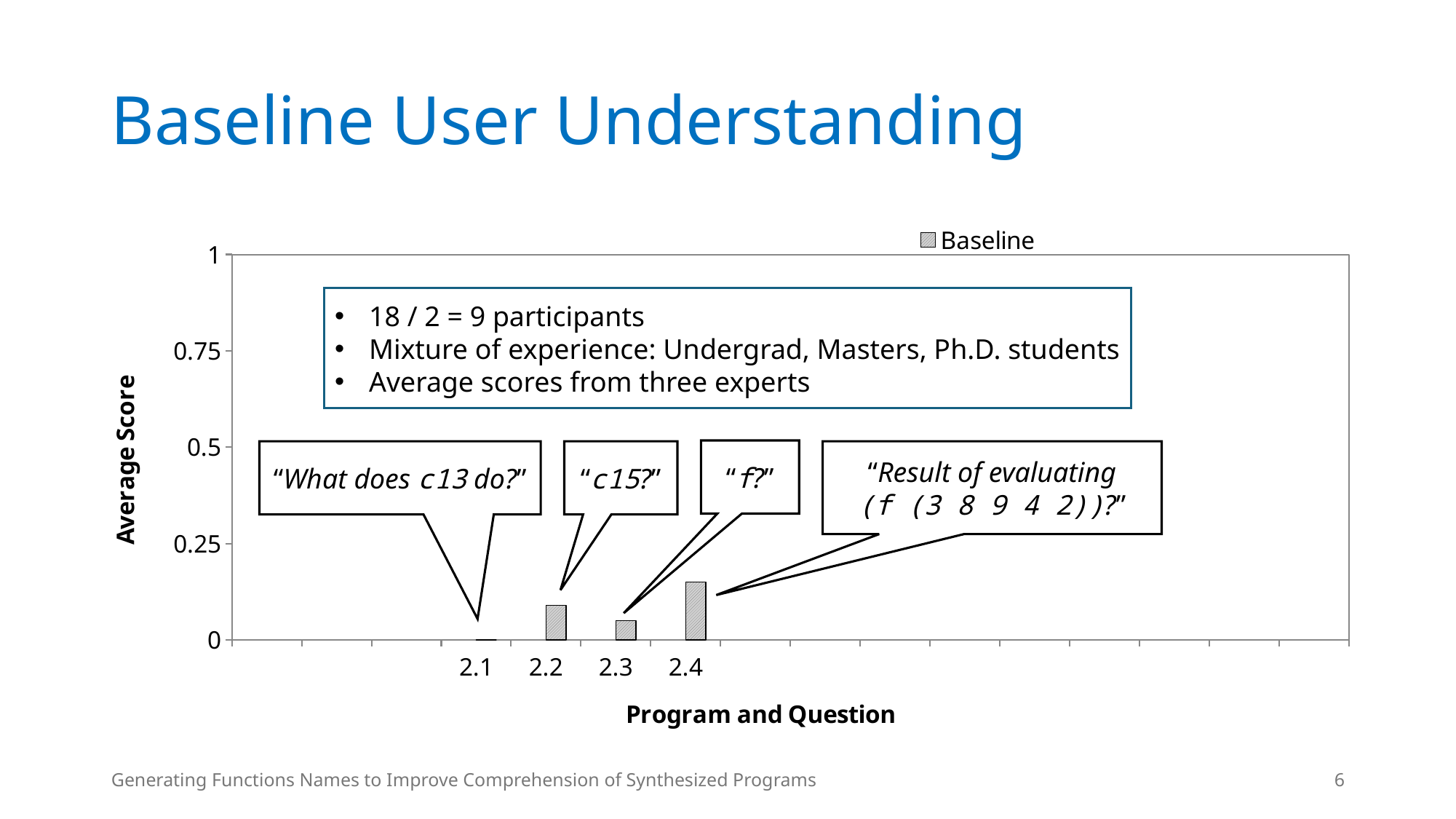
Is the value for category 2.4 greater or less than 0.25? less How many series does the chart legend list? 1 Which category has the lowest average score in the chart? 2.1 What is the highest value shown on the y axis of the chart? 1 What kind of chart is shown on the slide? bar chart Which category has the highest average score in the chart? 2.4 What is the name of the series shown in the chart legend? Baseline Is the value for category 2.2 greater or less than 0.25? less Which has a higher average score, category 2.4 or category 2.2? 2.4 What is the title of the y axis of the chart? Average Score How many labeled categories are shown on the x axis of the chart? 4 Which has a higher average score, category 2.2 or category 2.3? 2.2